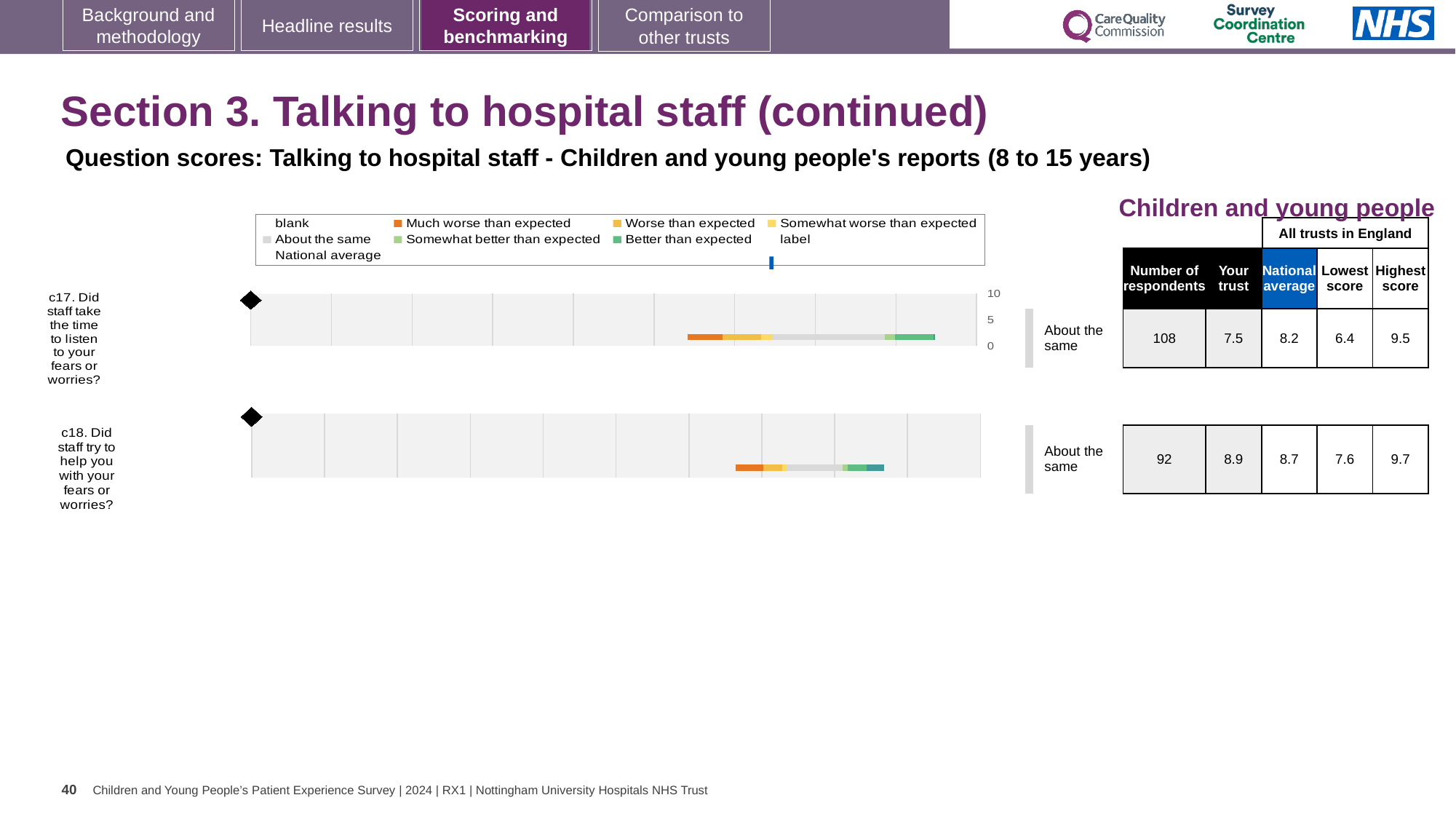
What is the 'Your trust' score for c18 (Did staff try to help you with your fears or worries?)? 8.9 How many questions are plotted on the slide? 2 For c18, what is the difference between the highest score and the lowest score across all trusts in England? 2.1 What benchmark category is shown for c17? About the same What kind of chart is used to show the question scores for c17 and c18? bar chart For c17, which is larger: the trust's score or the national average? National average For c17, how much higher is the national average than the trust's score? 0.7 What is the 'Your trust' score for c17 (Did staff take the time to listen to your fears or worries?)? 7.5 What is the highest score across all trusts in England for c17? 9.5 How many respondents answered c18? 92 What is the national average score for c17? 8.2 Which question has the higher 'Your trust' score, c17 or c18? c18